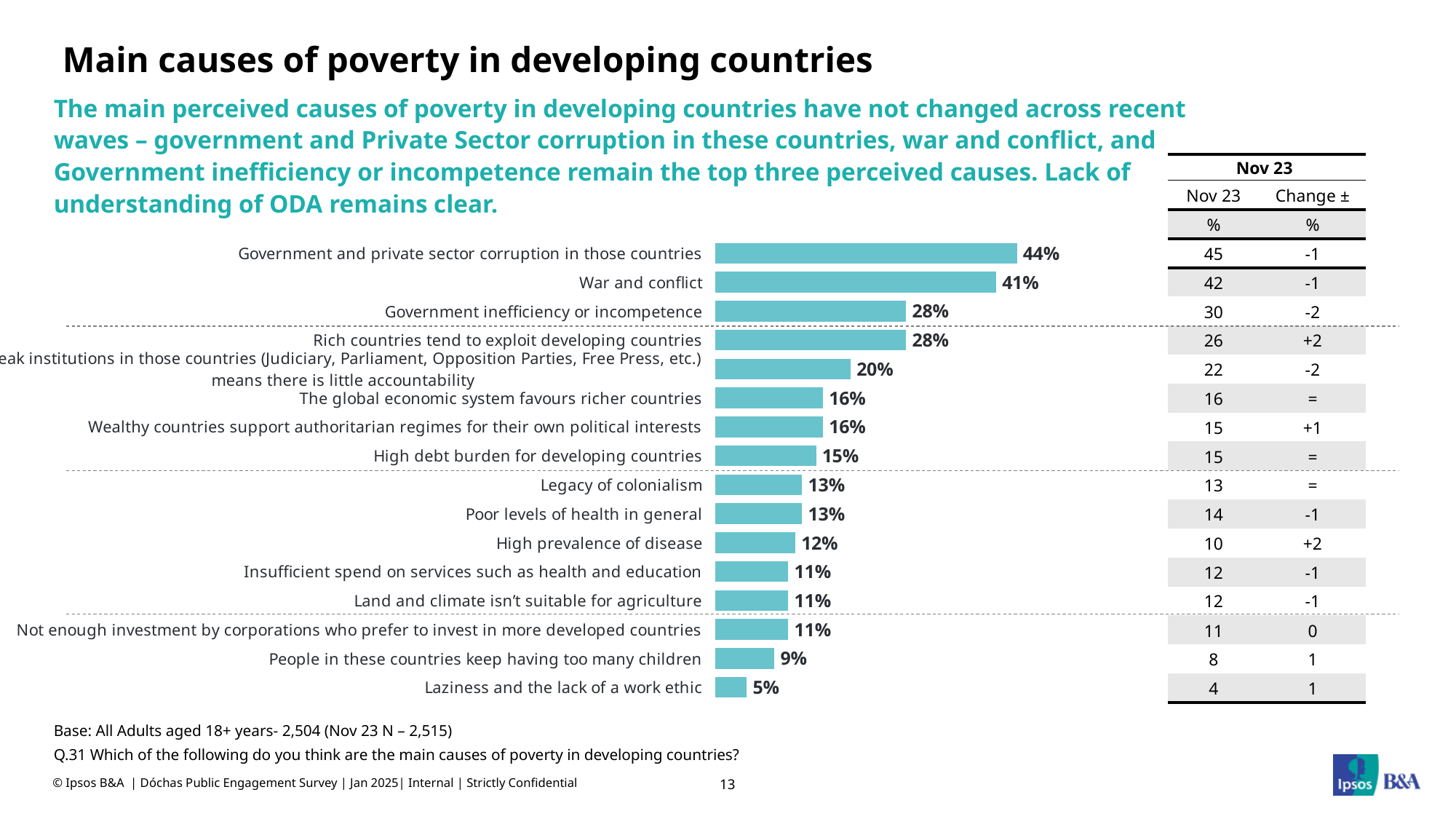
Which cause has the highest percentage in the chart? Government and private sector corruption in those countries What is the title of the slide containing the chart? Main causes of poverty in developing countries What is the value for "People in these countries keep having too many children"? 9% How many causes (bars) are shown in the chart? 16 What kind of chart is shown on the slide? Bar chart What percentage is shown for "High debt burden for developing countries"? 15% What percentage is shown for "War and conflict"? 41% Which is larger: the value for "War and conflict" or the value for "Government inefficiency or incompetence"? War and conflict What is the difference in percentage points between "Rich countries tend to exploit developing countries" and "Laziness and the lack of a work ethic"? 23 percentage points What is the difference in percentage points between "Government and private sector corruption in those countries" and "War and conflict"? 3 percentage points What is the value for "Legacy of colonialism"? 13% Which cause has the lowest percentage in the chart? Laziness and the lack of a work ethic